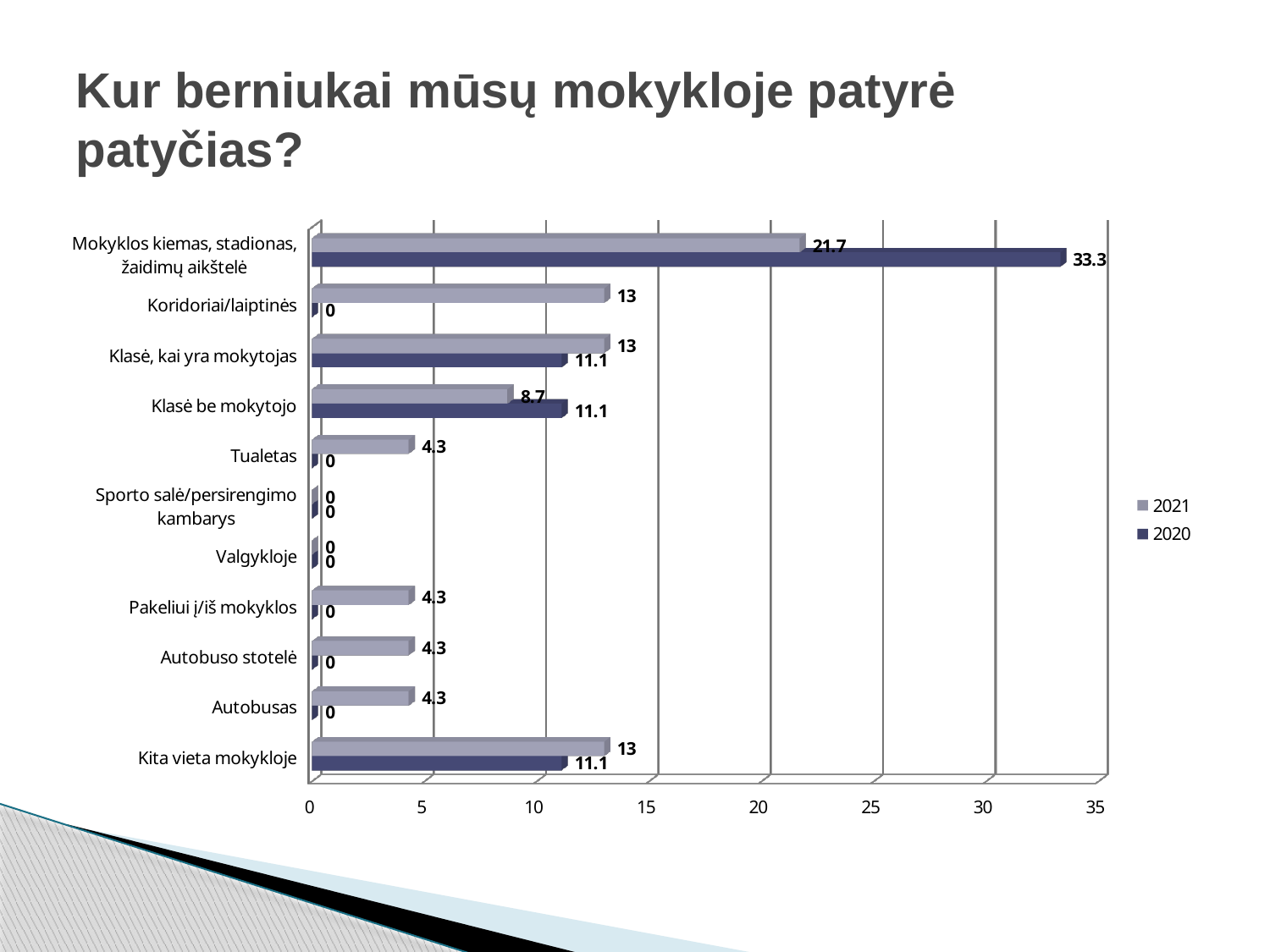
How many categories are shown on the chart? 11 What kind of chart is shown on the slide? bar chart What is the 2021 value for Koridoriai/laiptinės? 13 What is the 2020 value for Mokyklos kiemas, stadionas, žaidimų aikštelė? 33.3 What is the 2020 value for Kita vieta mokykloje? 11.1 Which category has the highest 2021 value? Mokyklos kiemas, stadionas, žaidimų aikštelė Is the 2020 value for Mokyklos kiemas, stadionas, žaidimų aikštelė greater or less than 30? greater Which is larger for Klasė, kai yra mokytojas: the 2021 value or the 2020 value? 2021 What is the 2021 value for Klasė be mokytojo? 8.7 How many series does the legend list? 2 What is the title of the slide? Kur berniukai mūsų mokykloje patyrė patyčias? What is the difference between the 2020 and 2021 values for Mokyklos kiemas, stadionas, žaidimų aikštelė? 11.6